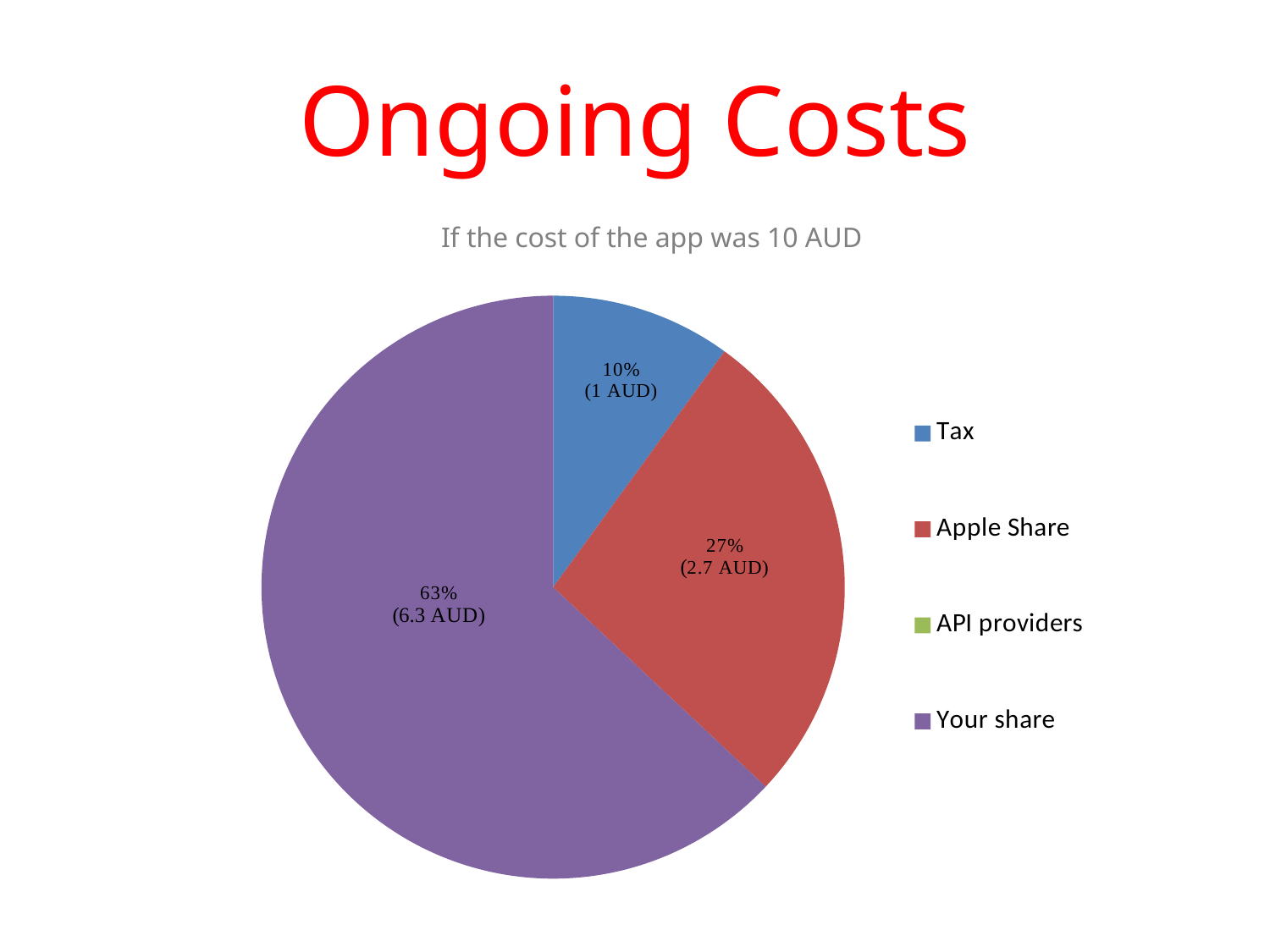
How many entries does the legend list? 4 What percentage of the pie does the Apple Share slice represent? 27% What amount in AUD is shown for the Your share slice? 6.3 AUD What colour is the Your share slice? Purple What is the difference in percentage points between the Your share slice and the Apple Share slice? 36 What amount in AUD is shown for the Tax slice? 1 AUD What type of chart is shown on the slide? Pie chart What percentage of the pie does the Your share slice represent? 63% What amount in AUD is shown for the Apple Share slice? 2.7 AUD Which is larger, the Tax slice or the Apple Share slice? Apple Share What percentage of the pie does the Tax slice represent? 10% Which slice of the pie is the largest? Your share